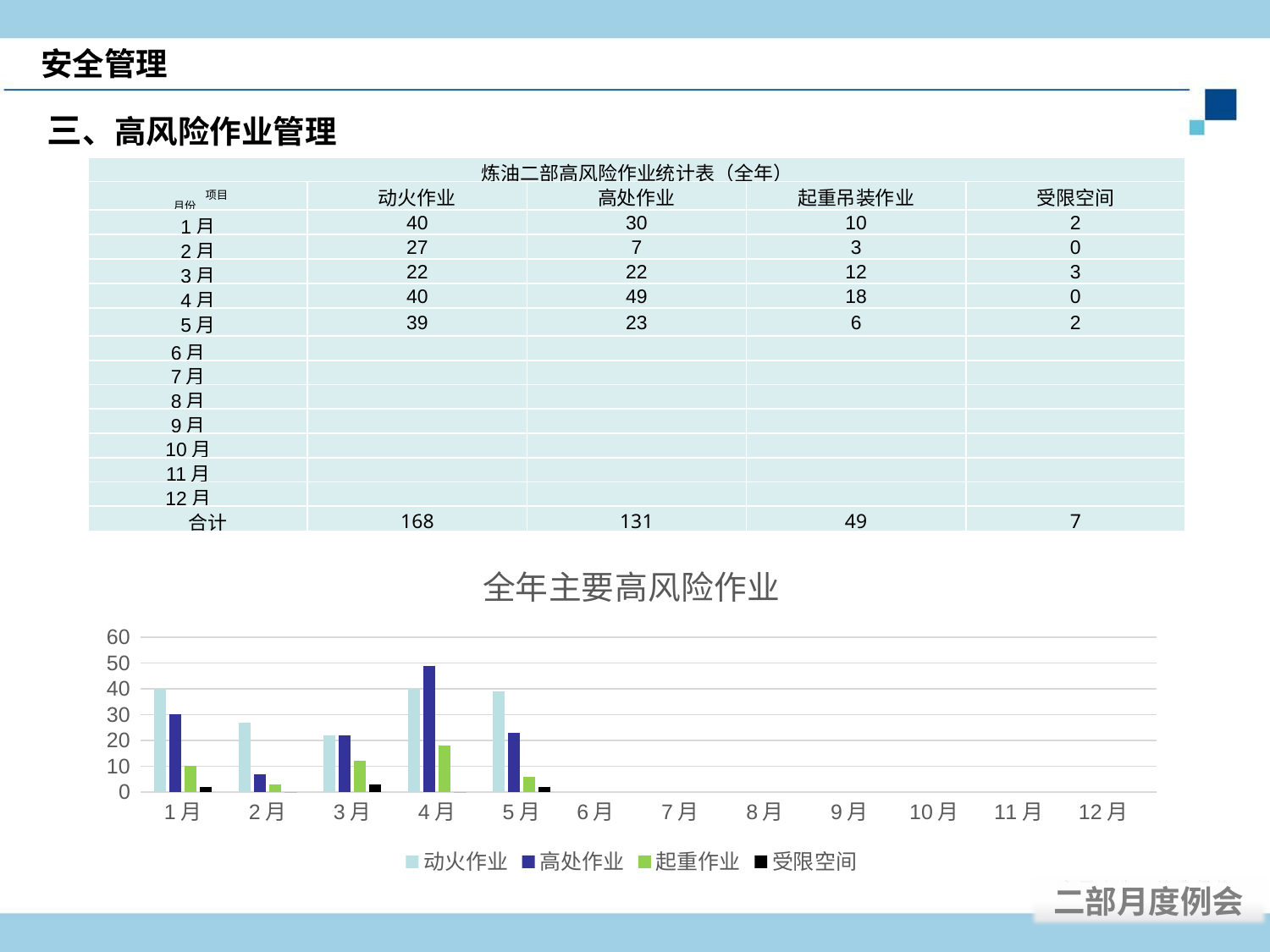
How many month categories are shown on the x axis of the chart? 12 How many series does the chart legend list? 4 In which month is the 高处作业 bar the highest? 4月 What is the value of 动火作业 in 1月? 40 What is the value of 高处作业 in 4月? 49 In 1月, which is larger, 动火作业 or 高处作业? 动火作业 Does the 起重作业 value rise or fall from 1月 to 2月? fall Among 1月 to 5月, which month has the lowest 动火作业 value? 3月 What kind of chart is shown on the slide? bar chart Is the value for 动火作业 in 2月 greater or less than 30? less What is the difference between 高处作业 and 动火作业 in 4月? 9 What is the title of the chart? 全年主要高风险作业